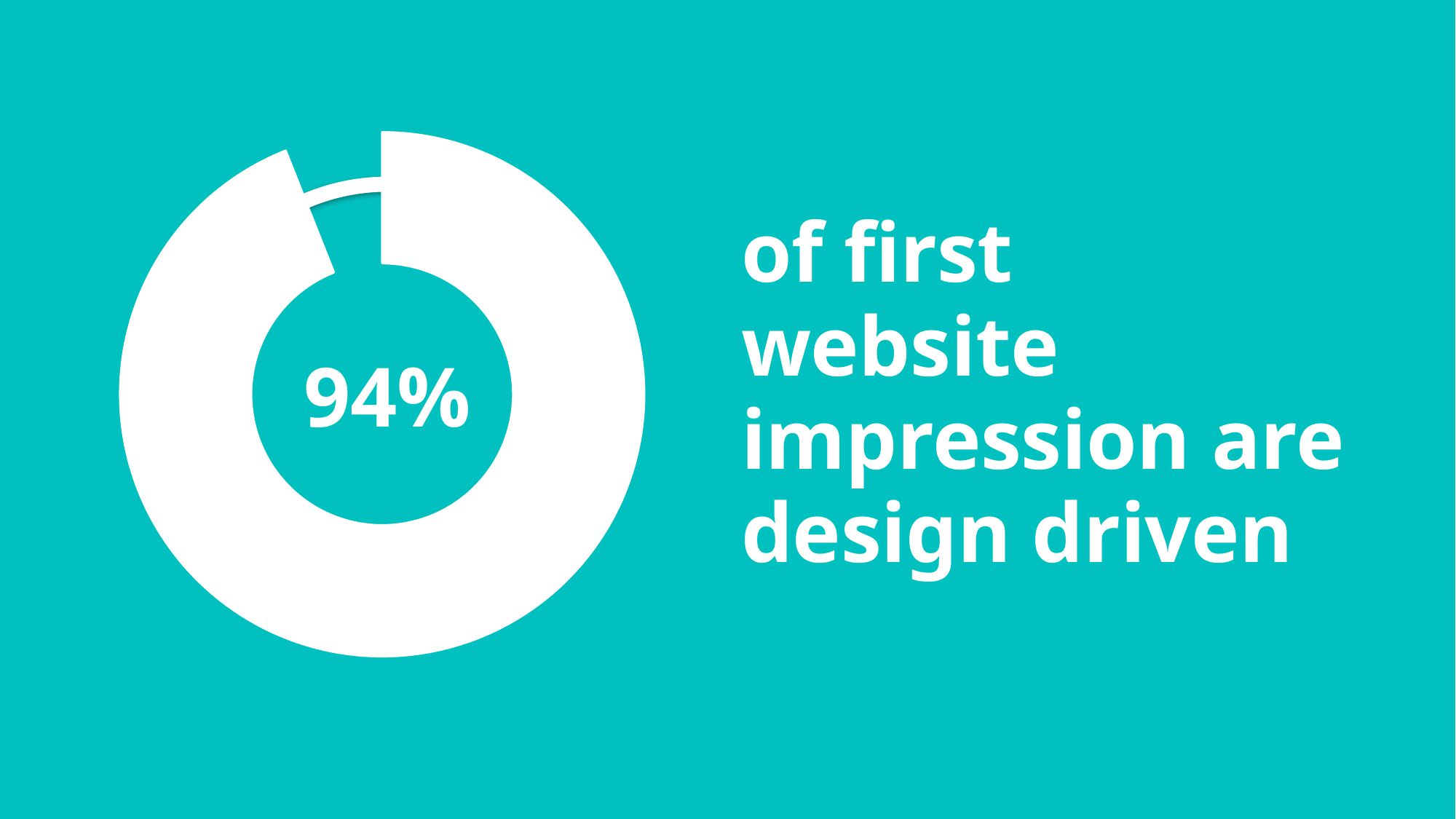
Which segment of the donut chart is larger, the filled white segment or the thin outlined segment? The filled white segment How many segments does the donut chart have? 2 What kind of chart is shown on the slide? Donut chart What colour is the large filled segment of the donut chart? White What share of the donut chart does the large white segment represent? 94% What percentage is printed in the centre of the donut chart? 94% According to the slide, what does the 94% figure describe? First website impressions that are design driven